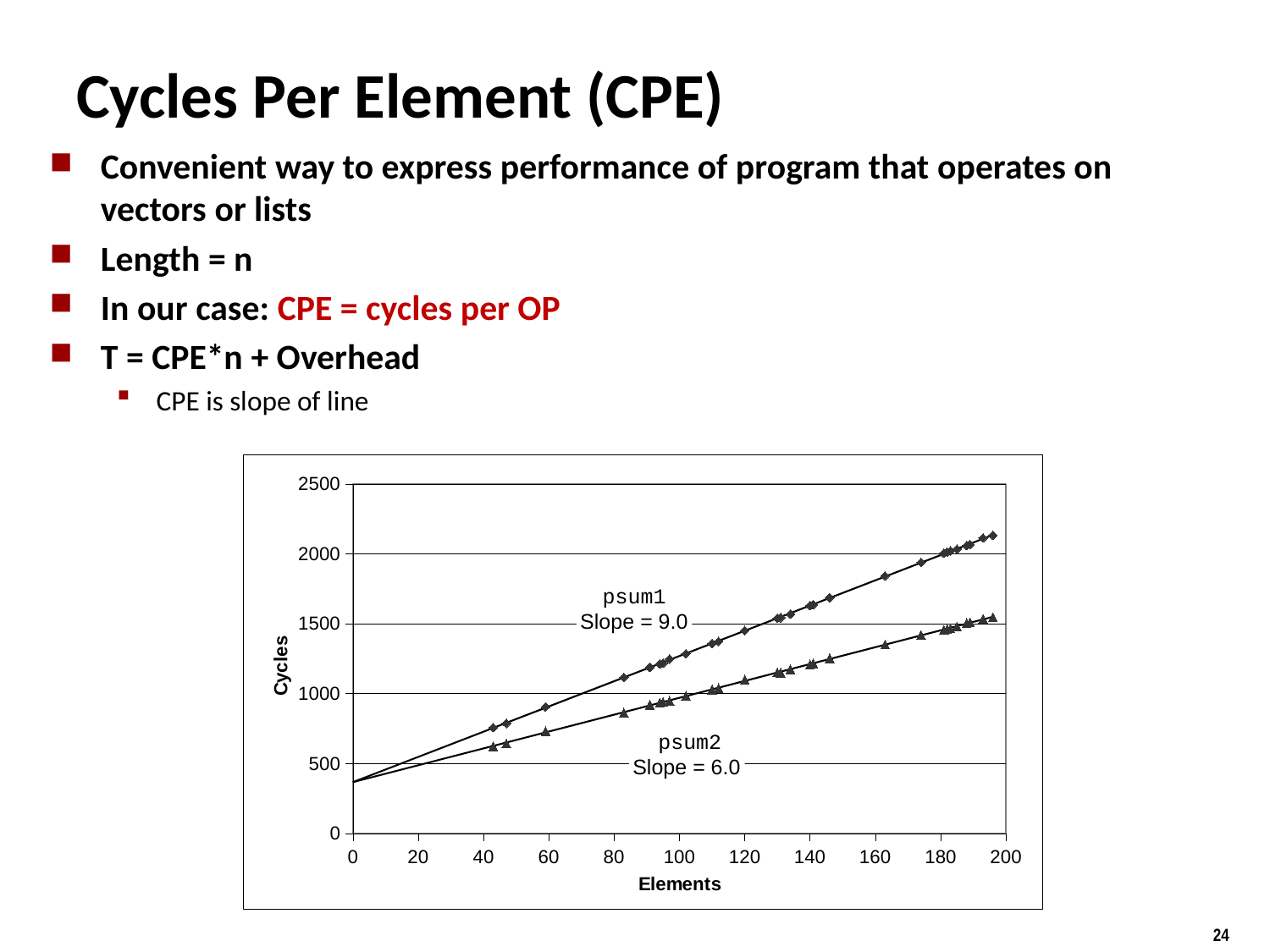
At 150 elements, which series has more cycles, psum1 or psum2? psum1 Is the value for psum1 at about 190 elements greater or less than 2000 cycles? greater Do the cycles for psum2 rise or fall as the number of elements increases? rise What is the slope shown for the psum1 line? 9.0 What is the title of the x axis of the chart? Elements Is the value for psum1 at about 60 elements greater or less than 1000 cycles? less What is the slope shown for the psum2 line? 6.0 What is the difference between the slope of psum1 and the slope of psum2? 3.0 Which series has the steeper slope, psum1 or psum2? psum1 How many data series are plotted on the chart? 2 What is the title of the y axis of the chart? Cycles